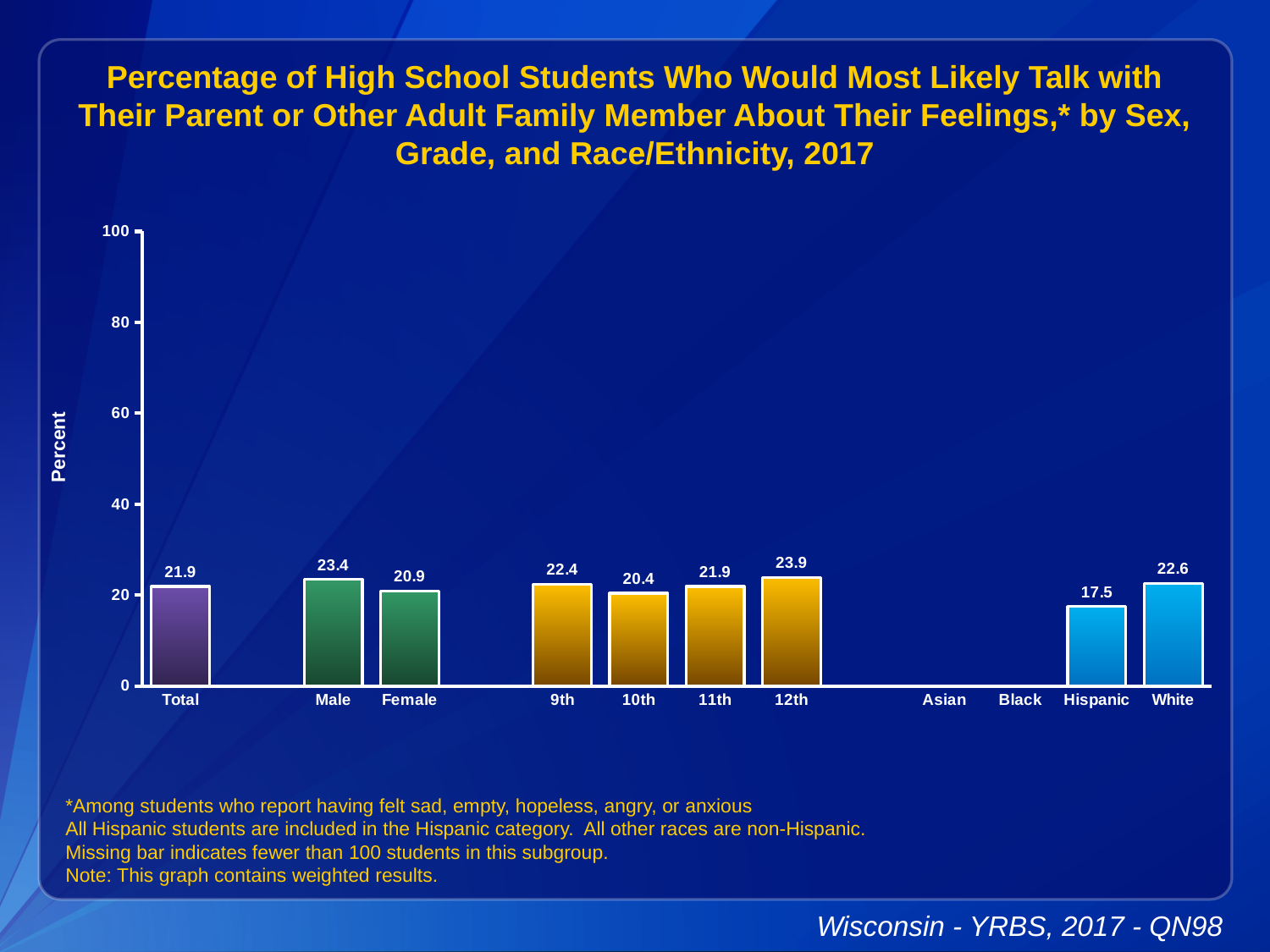
What is the value for 10th grade? 20.4 What is the difference between the Male and Female values? 2.5 Is the value for 12th grade greater or less than 40? less What is the value for Hispanic? 17.5 Which category with a plotted bar has the lowest value? Hispanic Which is larger, the value for White or the value for Hispanic? White Which grade has the highest value? 12th What is the label on the y axis? Percent What is the value for Male? 23.4 What kind of chart is shown? bar chart What is the value for Total? 21.9 How many categories on the x axis have no bar plotted? 2